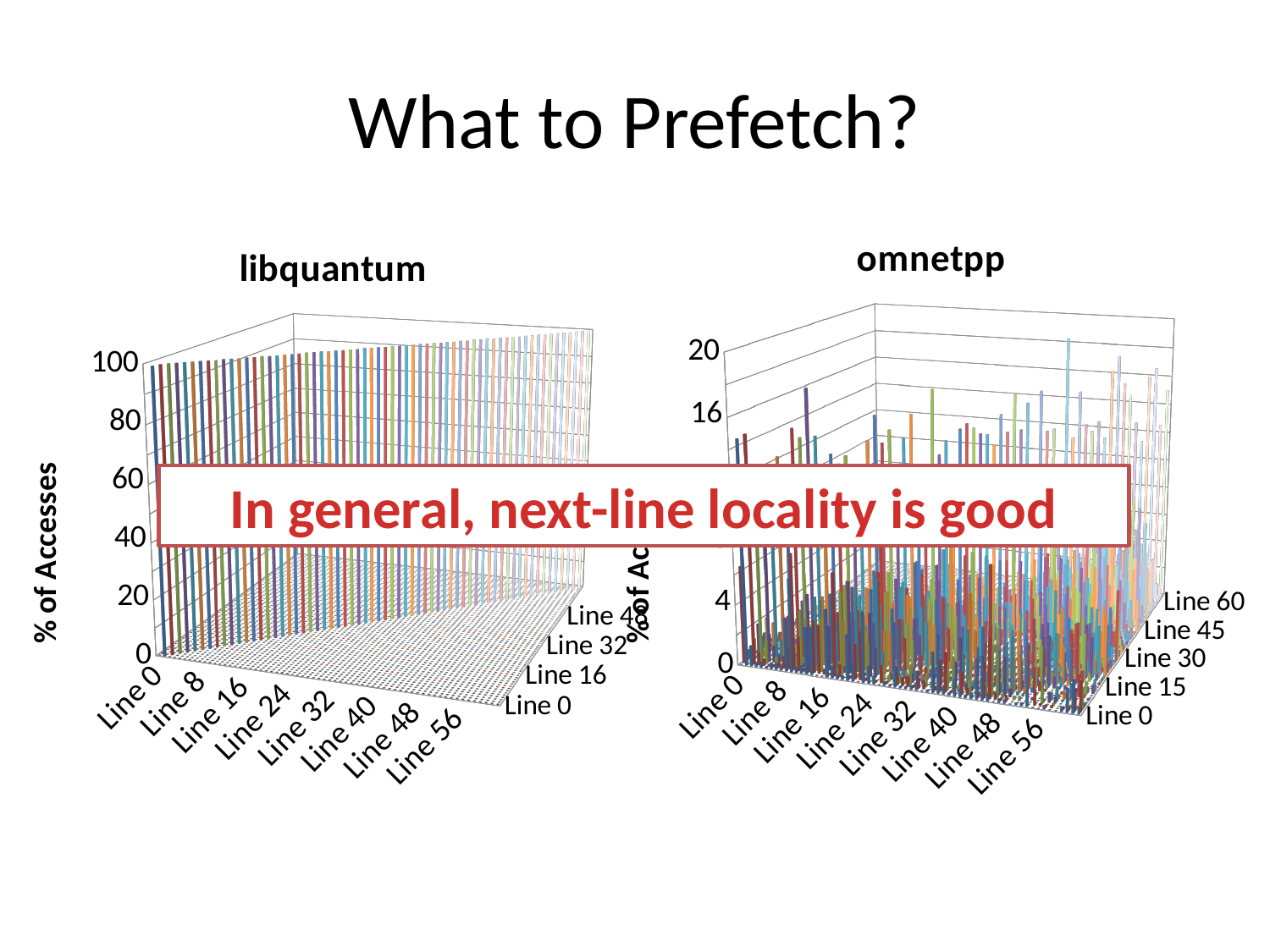
What is the title of the chart on the left? libquantum What is the last depth-axis label on the omnetpp chart? Line 60 On the omnetpp chart, is the tallest bar greater or less than 16? greater On the libquantum chart, what is the highest value shown on the vertical axis? 100 How many tick labels are shown along the front horizontal axis of the libquantum chart (Line 0 through Line 56)? 8 On the omnetpp chart, are most of the bars greater or less than 8? less On the libquantum chart, are the tallest bars greater or less than 80? greater What kind of chart is the omnetpp chart? 3D bar chart What is the vertical axis label on the libquantum chart? % of Accesses How many tick labels are shown along the depth axis of the omnetpp chart? 5 What kind of chart is the libquantum chart? 3D bar chart On the omnetpp chart, what is the highest value shown on the vertical axis? 20